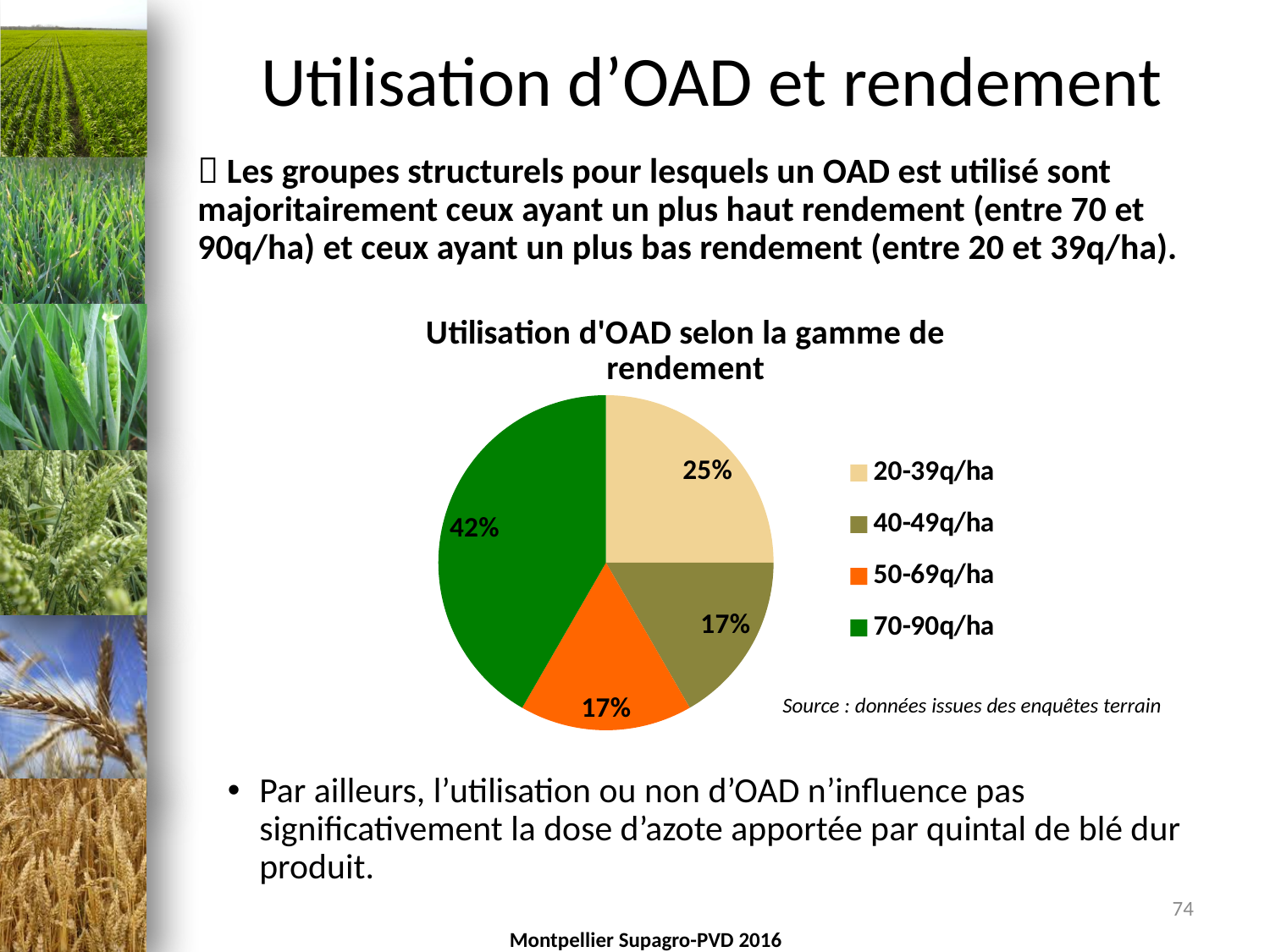
What kind of chart is shown on the slide? pie chart What is the value shown for the 40-49q/ha slice? 17% What is the title of the chart? Utilisation d'OAD selon la gamme de rendement What is the difference in percentage points between the 70-90q/ha slice and the 20-39q/ha slice? 17 What is the value shown for the 50-69q/ha slice? 17% What share of the pie does the 70-90q/ha category represent? 42% How many entries does the legend list? 4 What colour is the 50-69q/ha slice in the pie chart? orange What share of the pie does the 20-39q/ha category represent? 25% Which is larger, the share for 20-39q/ha or the share for 70-90q/ha? 70-90q/ha Which yield range has the largest share of the pie? 70-90q/ha How many slices does the pie chart have? 4